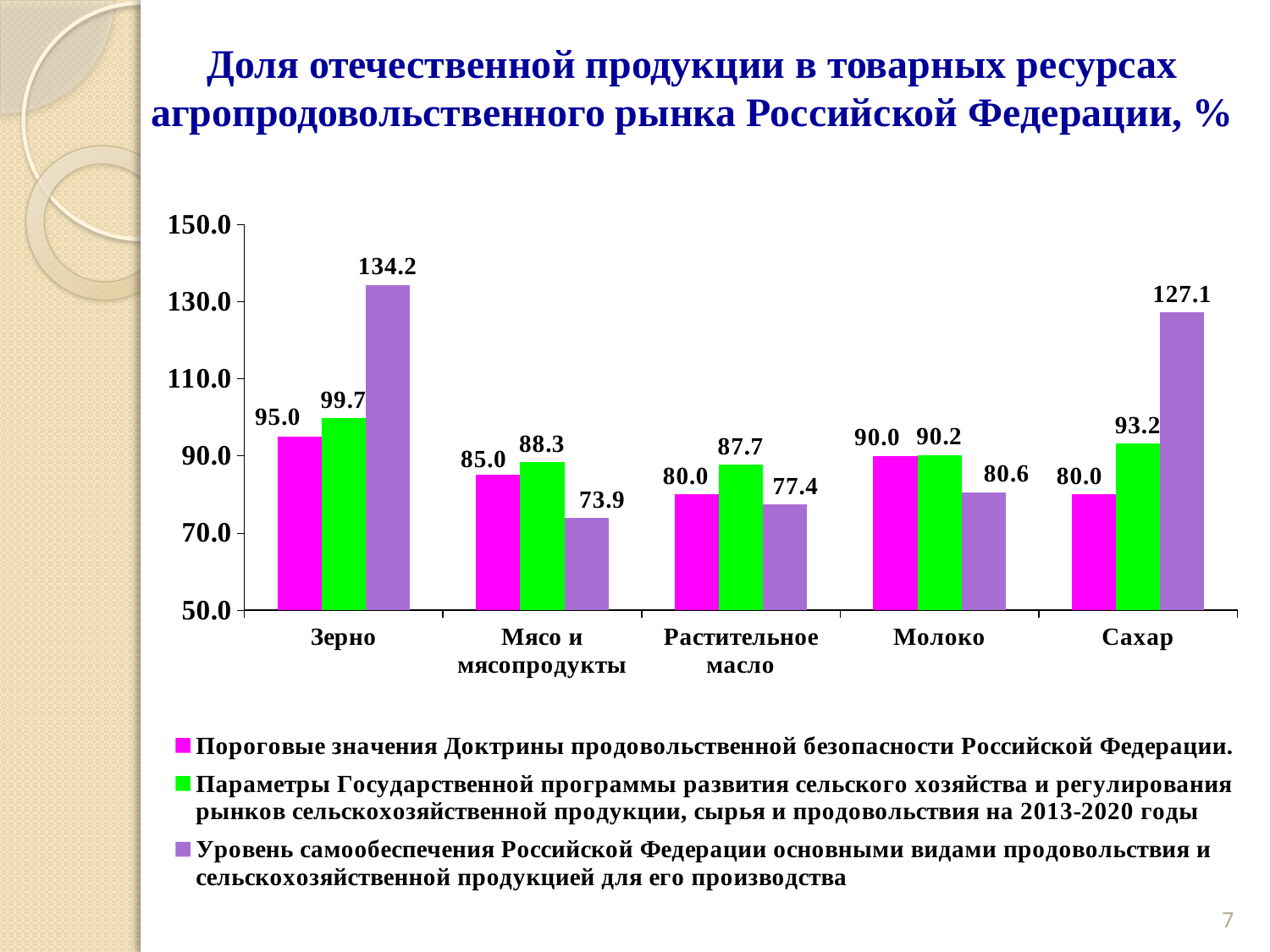
What is the State programme parameter (green series) for Растительное масло? 87.7 What is the Doctrine threshold value (magenta series) for Молоко? 90.0 How many product categories are shown on the x axis? 5 What is the difference between the self-sufficiency level and the Doctrine threshold for Сахар? 47.1 For Мясо и мясопродукты, which is larger: the State programme parameter or the self-sufficiency level? State programme parameter (88.3) What is the difference between the State programme parameter and the Doctrine threshold for Зерно? 4.7 Which category has the lowest self-sufficiency level (purple series)? Мясо и мясопродукты What kind of chart is shown on the slide? Bar chart How many series does the legend list? 3 Which category has the highest self-sufficiency level (purple series)? Зерно What is the self-sufficiency level (purple series) for Зерно? 134.2 Is the self-sufficiency level for Сахар greater or less than 110.0? greater